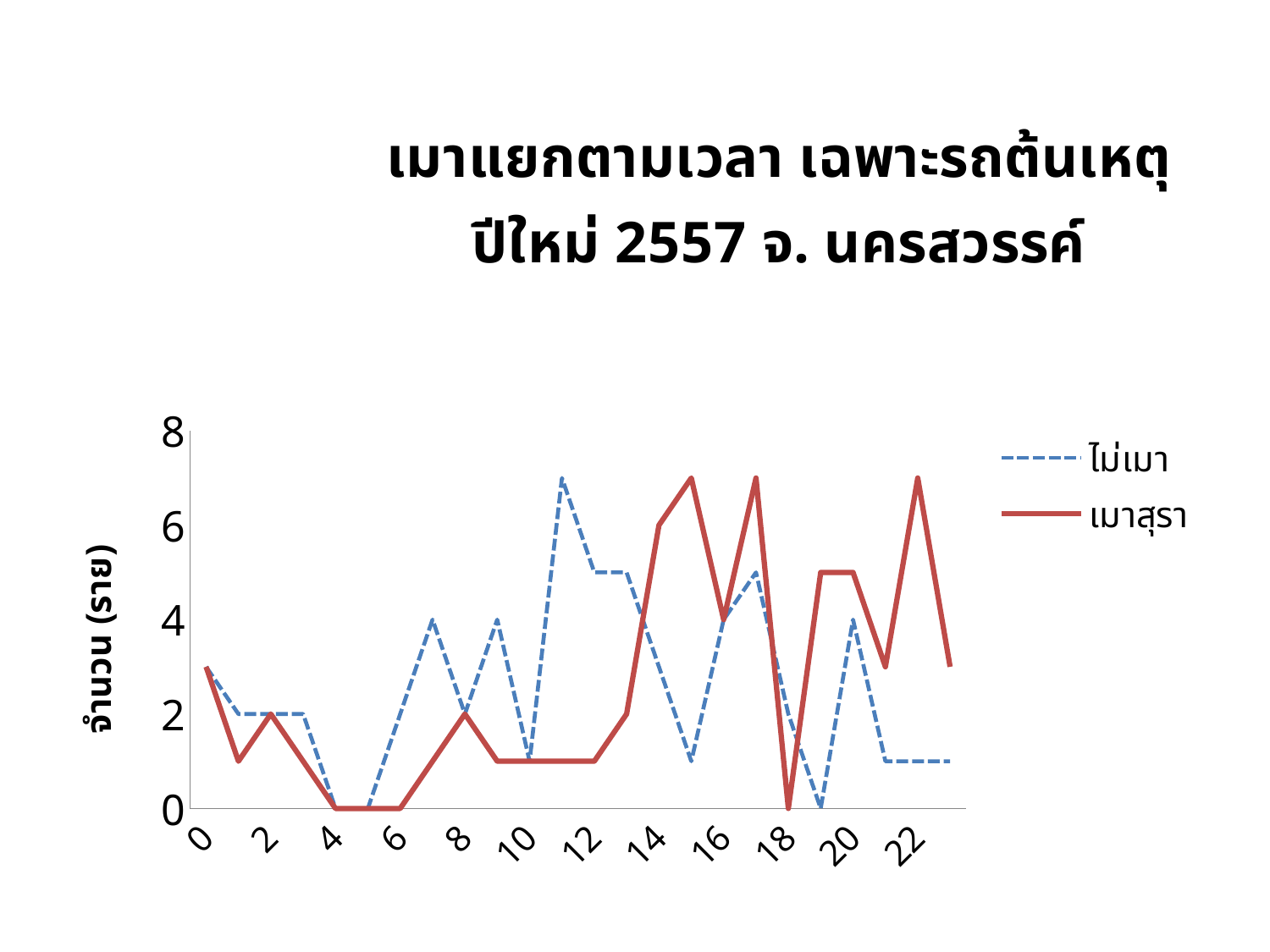
What is the value of the ไม่เมา series at hour 7? 4 What is the value of the เมาสุรา series at hour 18? 0 Is the value of the เมาสุรา series at hour 12 greater or less than 2? less At hour 15, which series has the larger value, ไม่เมา or เมาสุรา? เมาสุรา At hour 11, which series has the larger value, ไม่เมา or เมาสุรา? ไม่เมา Is the value of the เมาสุรา series at hour 22 greater or less than 6? greater What is the value of the เมาสุรา series at hour 14? 6 How many series does the legend list? 2 At which hour does the ไม่เมา series reach its highest value? 11 What kind of chart is shown on the slide? line chart What are the two series named in the legend? ไม่เมา and เมาสุรา What is the label on the vertical axis? จำนวน (ราย)